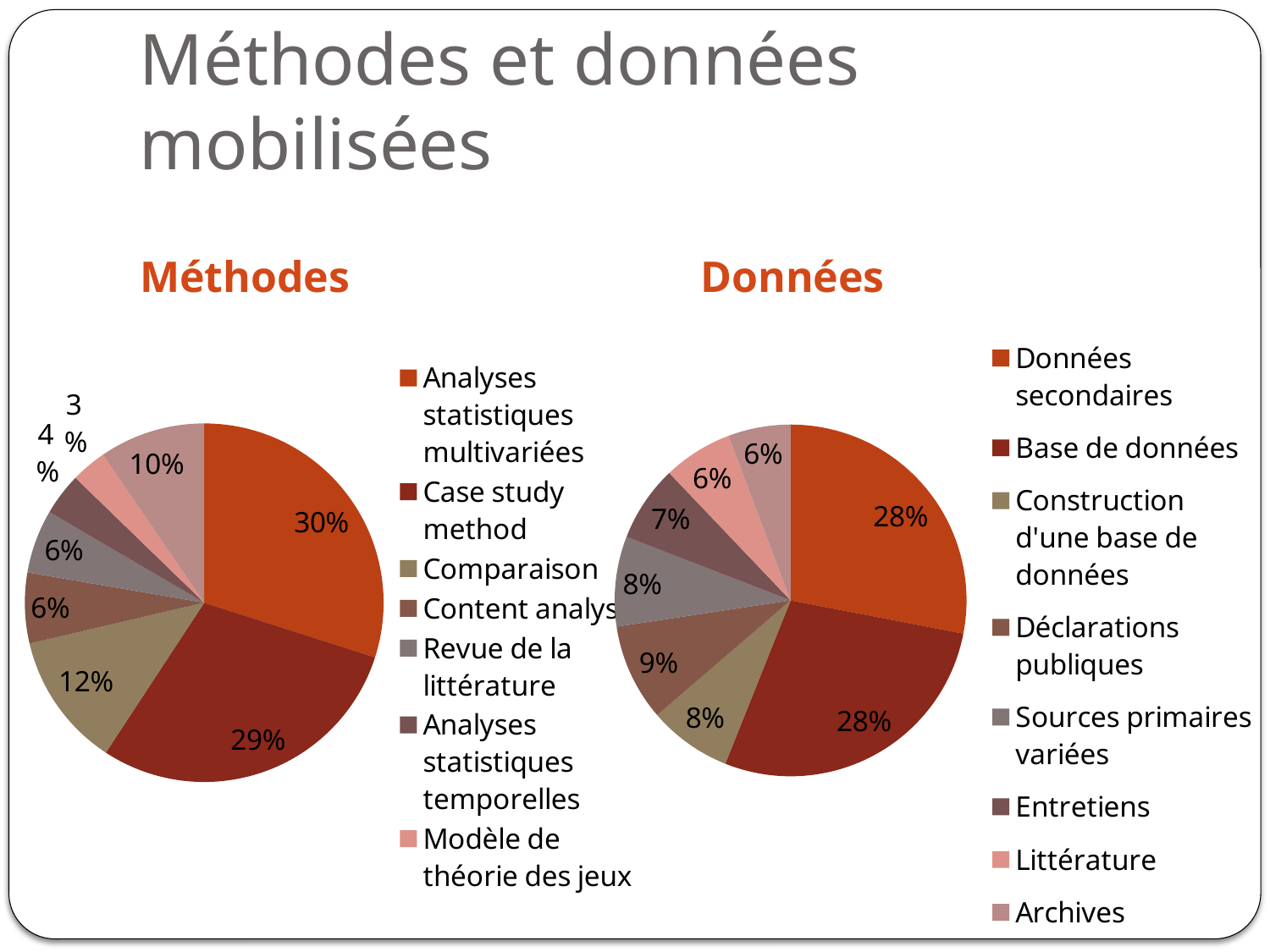
On the Méthodes chart, what share is Analyses statistiques multivariées? 30% On the Méthodes chart, what share is Comparaison? 12% On the Méthodes chart, which category has the largest share? Analyses statistiques multivariées On the Données chart, what share is Entretiens? 7% On the Données chart, what share is Déclarations publiques? 9% What kind of chart is the Données chart? Pie chart On the Méthodes chart, what is the difference between Analyses statistiques multivariées and Comparaison? 18% On the Données chart, how many entries does the legend list? 8 On the Données chart, what is the combined share of Données secondaires and Base de données? 56% On the Méthodes chart, what share is Case study method? 29% On the Données chart, which is larger, Déclarations publiques or Sources primaires variées? Déclarations publiques On the Données chart, what share is Base de données? 28%